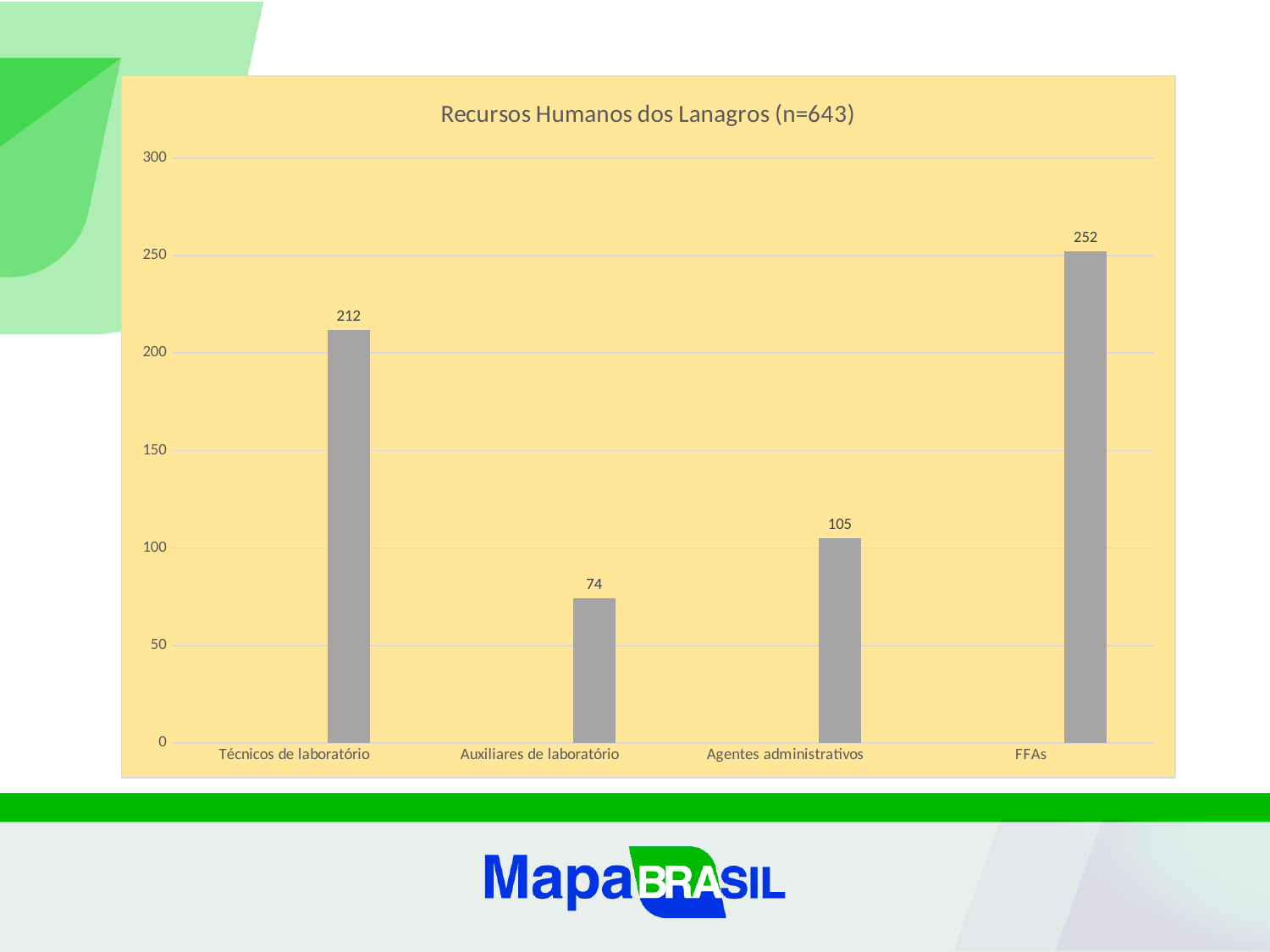
What is the value for FFAs? 252 What is the value for Técnicos de laboratório? 212 What is the title of the chart? Recursos Humanos dos Lanagros (n=643) What is the difference between the values for FFAs and Técnicos de laboratório? 40 Which is larger, the value for Técnicos de laboratório or the value for Agentes administrativos? Técnicos de laboratório How many categories are shown on the x axis? 4 What is the value for Agentes administrativos? 105 Which category has the lowest value? Auxiliares de laboratório What kind of chart is shown on the slide? Bar chart What is the value for Auxiliares de laboratório? 74 What is the difference between the values for Agentes administrativos and Auxiliares de laboratório? 31 Which category has the highest value? FFAs